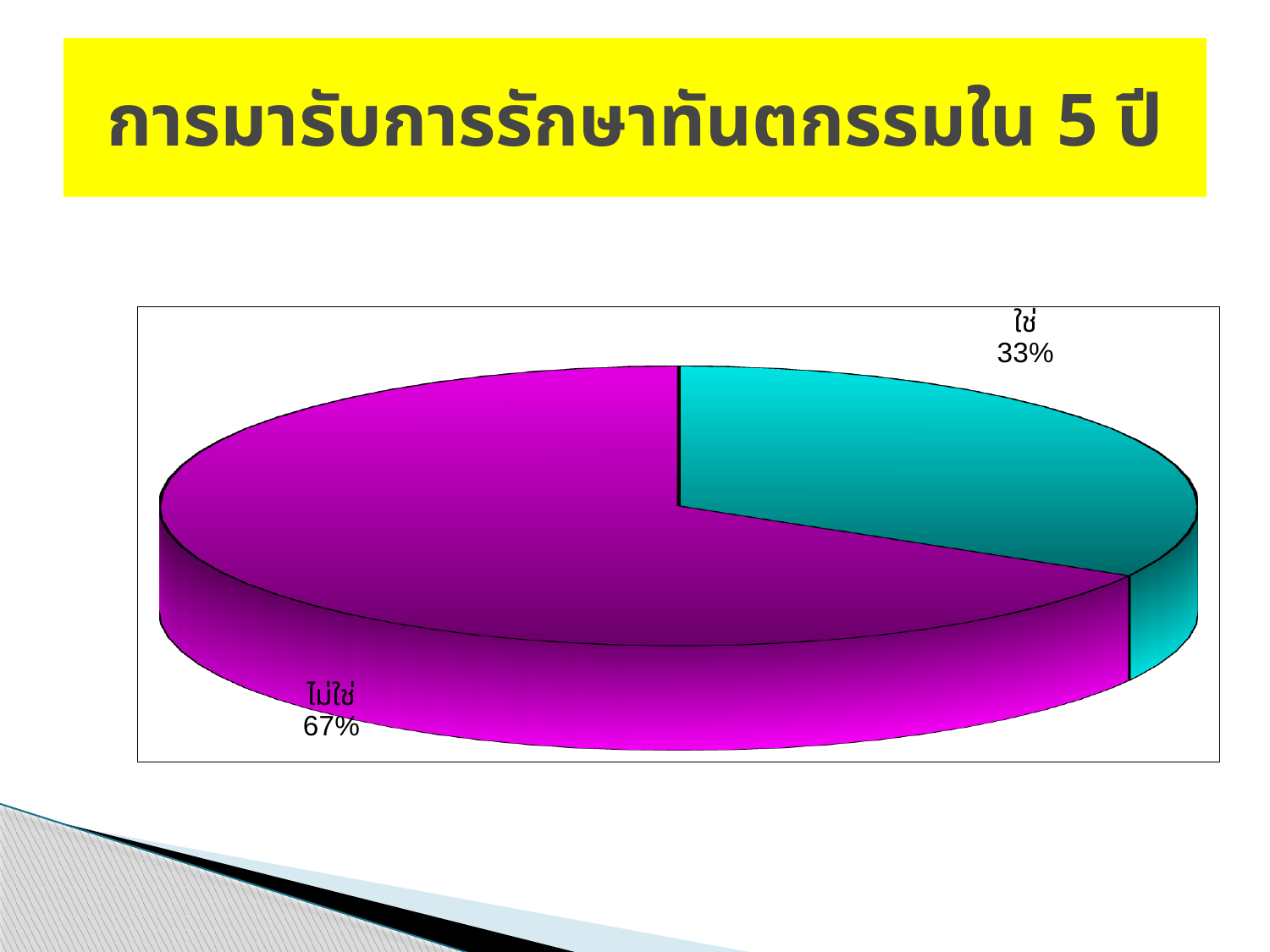
What is the difference in percentage points between the ไม่ใช่ slice and the ใช่ slice? 34 What share of the pie does the ไม่ใช่ slice represent? 67% What kind of chart is shown on the slide? pie chart Which slice is the largest in the pie chart? ไม่ใช่ What is the title of the slide above the chart? การมารับการรักษาทันตกรรมใน 5 ปี Which slice is the smallest in the pie chart? ใช่ How many slices does the pie chart have? 2 Which is larger, the ใช่ slice or the ไม่ใช่ slice? ไม่ใช่ What share of the pie does the ใช่ slice represent? 33% What colour is the ใช่ slice of the pie chart? teal